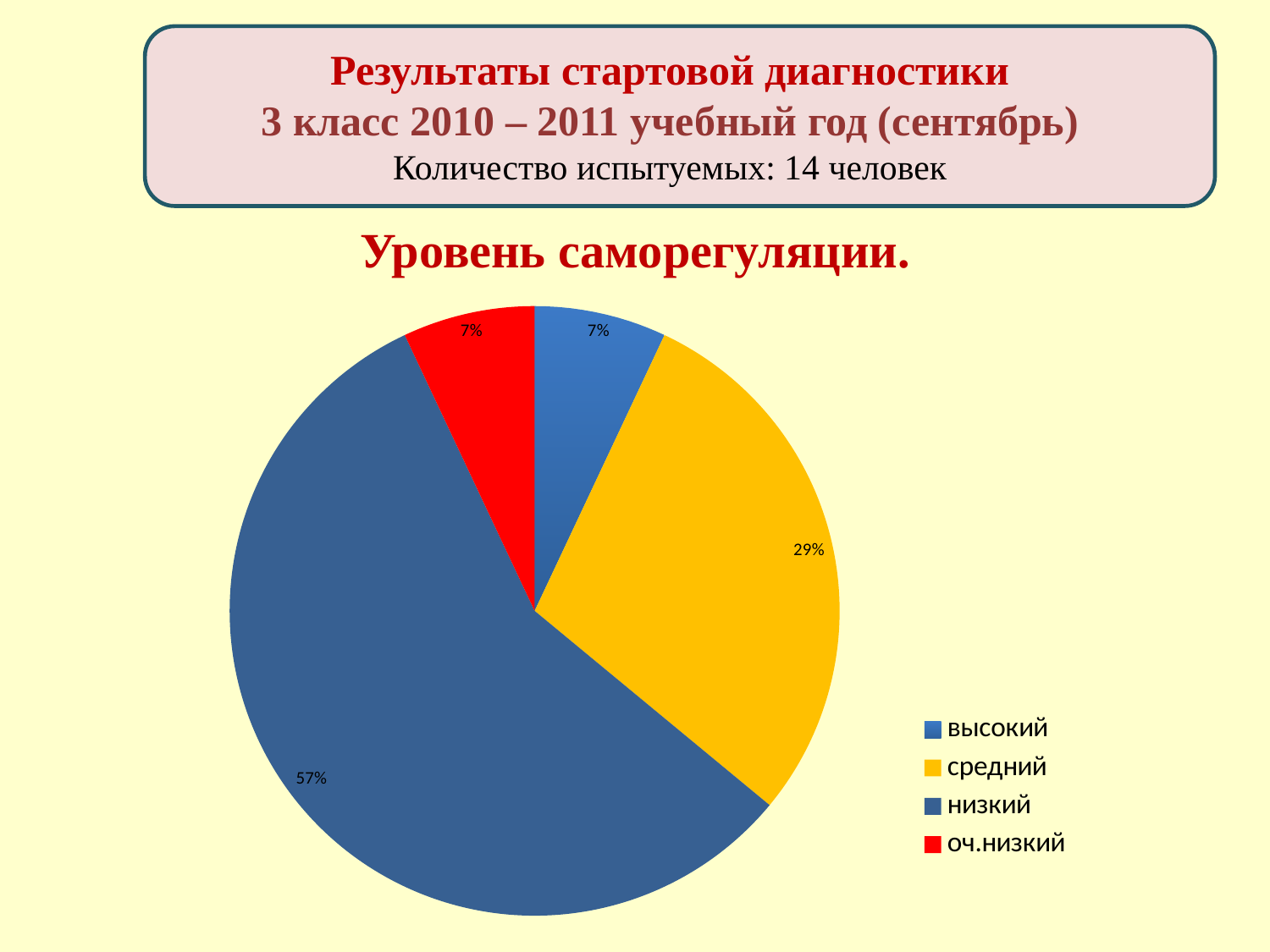
What share of the pie does the 'низкий' slice represent? 57% What share of the pie does the 'оч.низкий' slice represent? 7% Which is larger, the 'средний' slice or the 'высокий' slice? средний What share of the pie does the 'высокий' slice represent? 7% What colour is the 'оч.низкий' slice? red What kind of chart is shown on the slide? pie chart Which category has the largest slice of the pie? низкий How many entries does the legend list? 4 What is the difference between the 'низкий' share and the 'средний' share? 28% How many slices does the pie chart have? 4 What is the title of the chart? Уровень саморегуляции.